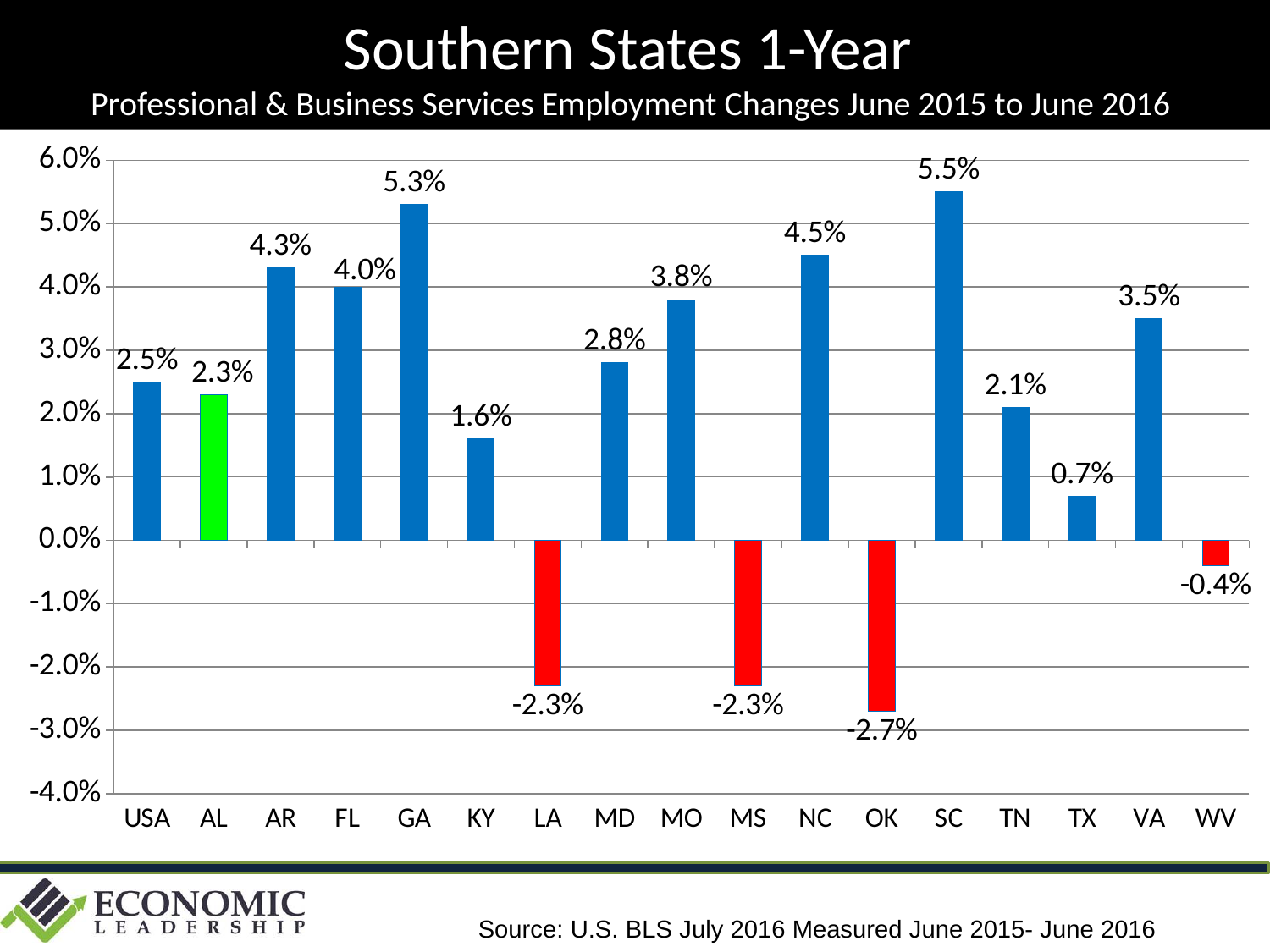
Which is larger, the value for NC or the value for MO? NC How many categories are shown on the x axis? 17 Which bar is coloured green? AL What is the value for AL? 2.3% What is the value for GA? 5.3% Is the value for FL greater or less than 3.0%? greater Which category has the lowest value? OK Which category has the highest value? SC What is the value for WV? -0.4% What is the difference between the values for SC and USA? 3.0% What kind of chart is this? bar chart How many bars have negative values? 4